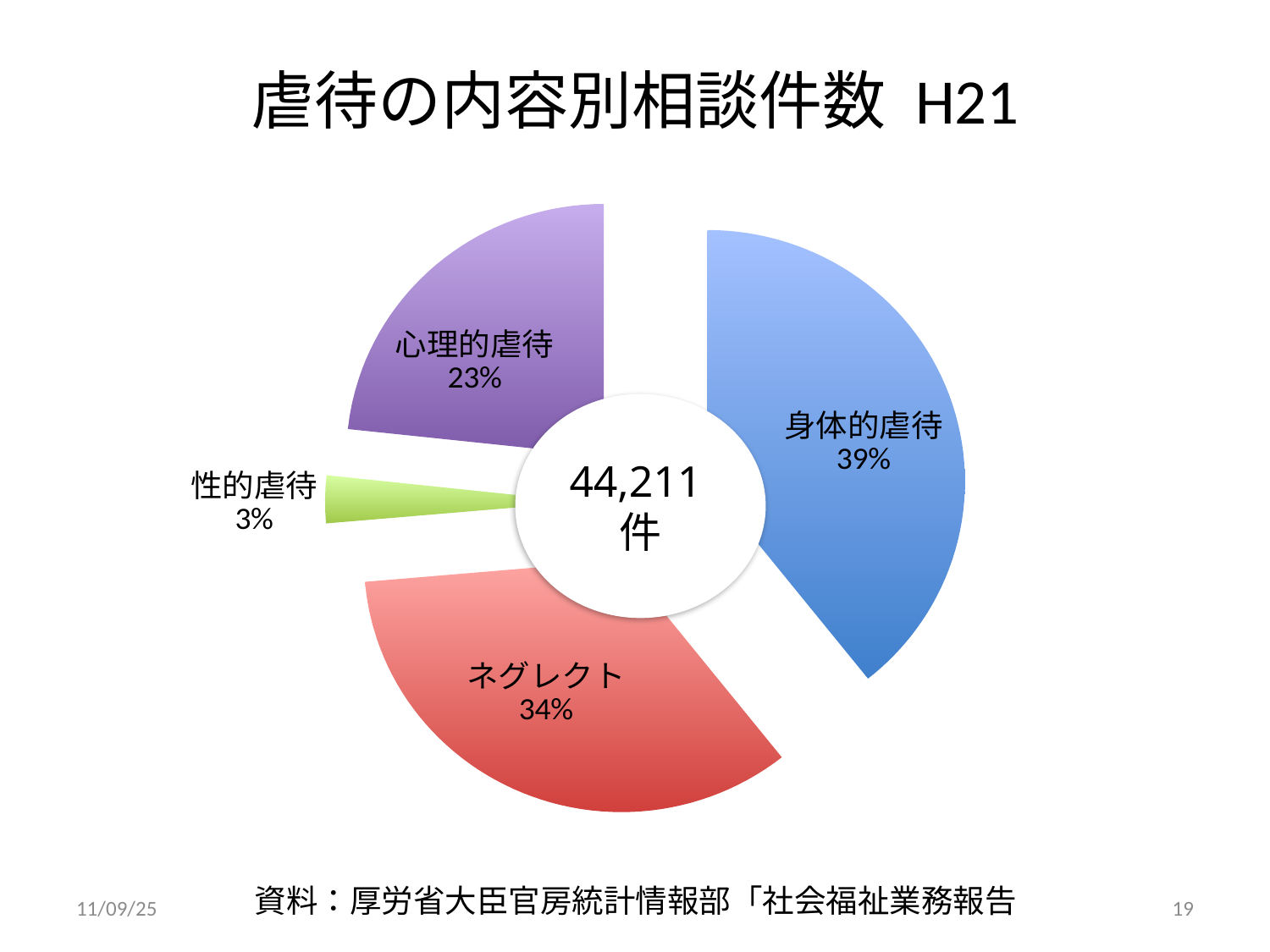
What share of the pie does 心理的虐待 account for? 23% Which has a larger share, ネグレクト or 心理的虐待? ネグレクト What share of the pie does 性的虐待 account for? 3% Which category has the smallest share of the pie? 性的虐待 What is the difference in percentage points between 身体的虐待 and ネグレクト? 5 percentage points Which category has the largest share of the pie? 身体的虐待 What share of the pie does ネグレクト account for? 34% What is the difference in percentage points between 心理的虐待 and 性的虐待? 20 percentage points What kind of chart is shown on the slide? Pie chart What total number of cases is shown in the centre of the chart? 44,211件 How many categories are shown in the pie chart? 4